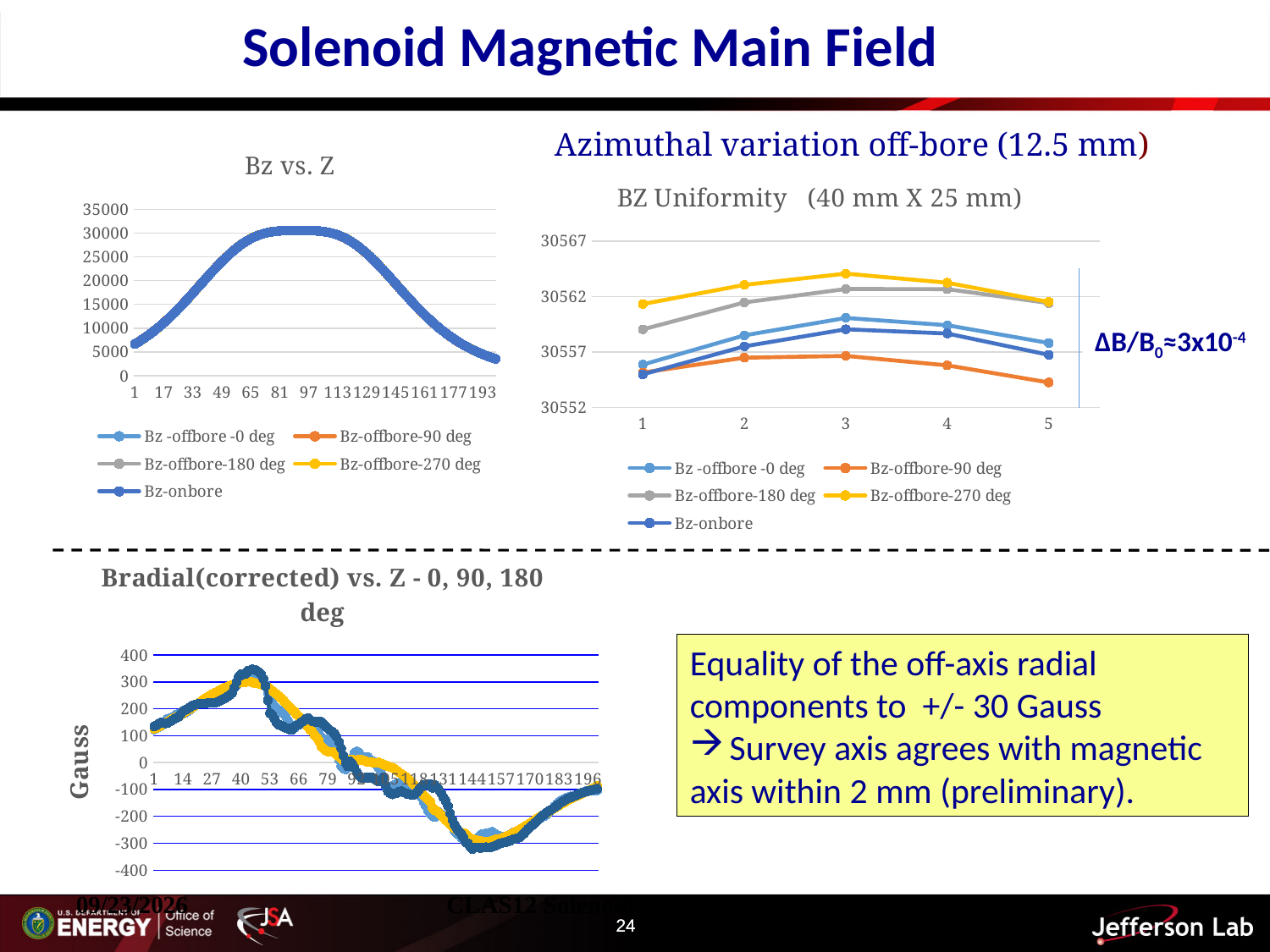
In the "Bradial(corrected) vs. Z - 0, 90, 180 deg" chart, is the minimum value greater or less than -200? less How many series does the legend of the "Bz vs. Z" chart list? 5 In the "BZ Uniformity (40 mm X 25 mm)" chart, which series has the highest values? Bz-offbore-270 deg What kind of chart is the "Bz vs. Z" chart at the top left of the slide? line chart In the "Bz vs. Z" chart, do the values rise or fall between Z = 1 and Z = 81? rise In the "BZ Uniformity (40 mm X 25 mm)" chart, which is larger at point 1: Bz-offbore-180 deg or Bz-offbore-90 deg? Bz-offbore-180 deg What is the y-axis label of the "Bradial(corrected) vs. Z - 0, 90, 180 deg" chart? Gauss In the "Bz vs. Z" chart, is the value at the last Z point (193) greater or less than 5000? less In the "BZ Uniformity (40 mm X 25 mm)" chart, is the value of Bz-offbore-270 deg at point 3 greater or less than 30562? greater How many x-axis points are plotted in the "BZ Uniformity (40 mm X 25 mm)" chart? 5 In the "BZ Uniformity (40 mm X 25 mm)" chart, which series has the lowest value at point 5? Bz-offbore-90 deg